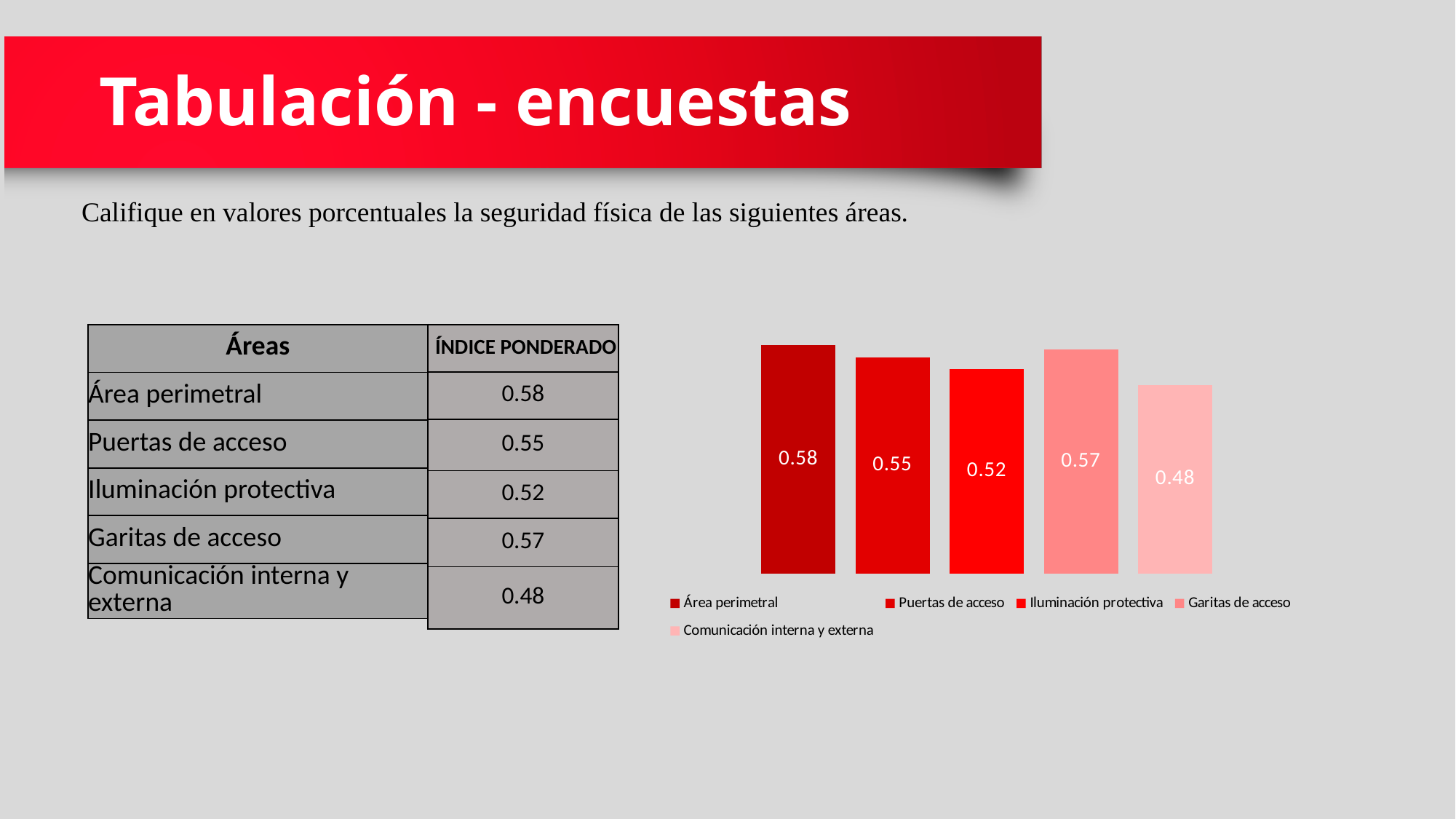
What is the value for Garitas de acceso? 0.57 Which is larger, the value for Garitas de acceso or the value for Puertas de acceso? Garitas de acceso What is the value for Área perimetral? 0.58 Which category has the lowest value? Comunicación interna y externa What is the value for Comunicación interna y externa? 0.48 What kind of chart is shown on the slide? Bar chart What is the value for Iluminación protectiva? 0.52 How many entries does the legend list? 5 Which category has the highest value? Área perimetral What is the value for Puertas de acceso? 0.55 How many bars are plotted in the chart? 5 What is the difference between the values for Área perimetral and Comunicación interna y externa? 0.10